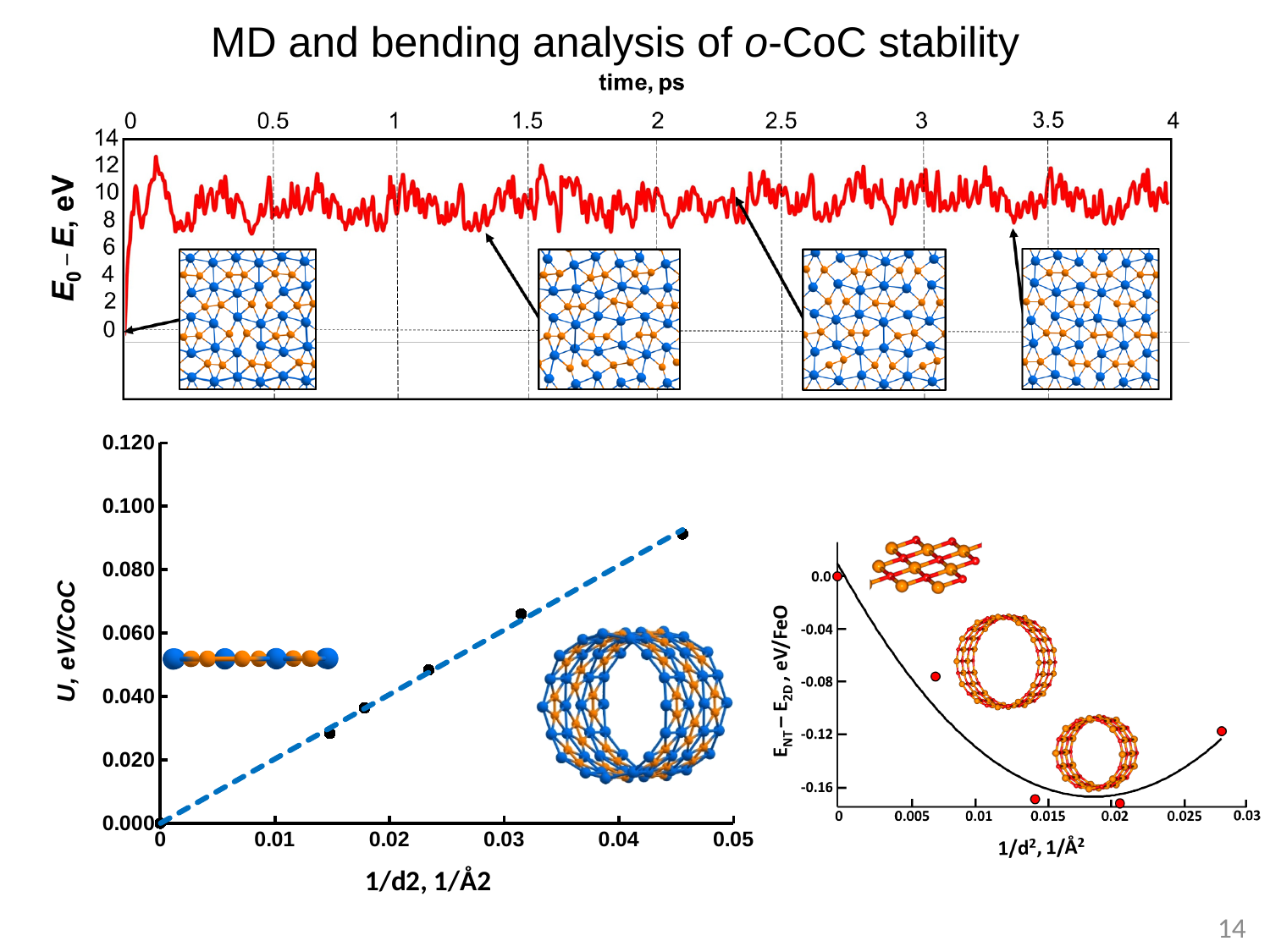
In the bottom-right chart (E_NT – E_2D vs 1/d²), which is larger: the value at 1/d² = 0 or the value at 1/d² near 0.014? the value at 1/d² = 0 In the top chart, is the value of E0 – E at time 3 ps greater or less than 12? less In the bottom-right chart (E_NT – E_2D vs 1/d²), how many red data points are plotted? 5 In the bottom-left chart (U vs 1/d2), how many data points are plotted? 6 In the bottom-right chart (E_NT – E_2D vs 1/d²), is the value for the point near 1/d² = 0.028 greater or less than -0.08? less What kind of chart is the top chart plotting E0 – E against time? line chart In the bottom-left chart (U vs 1/d2), is the value of U for the point near 1/d2 = 0.015 greater or less than 0.040? less In the bottom-left chart (U vs 1/d2), do the plotted values rise or fall as 1/d2 increases? rise In the top chart, what is the largest tick value shown on the time axis? 4 In the top chart, what is the unit of the x axis (time)? ps